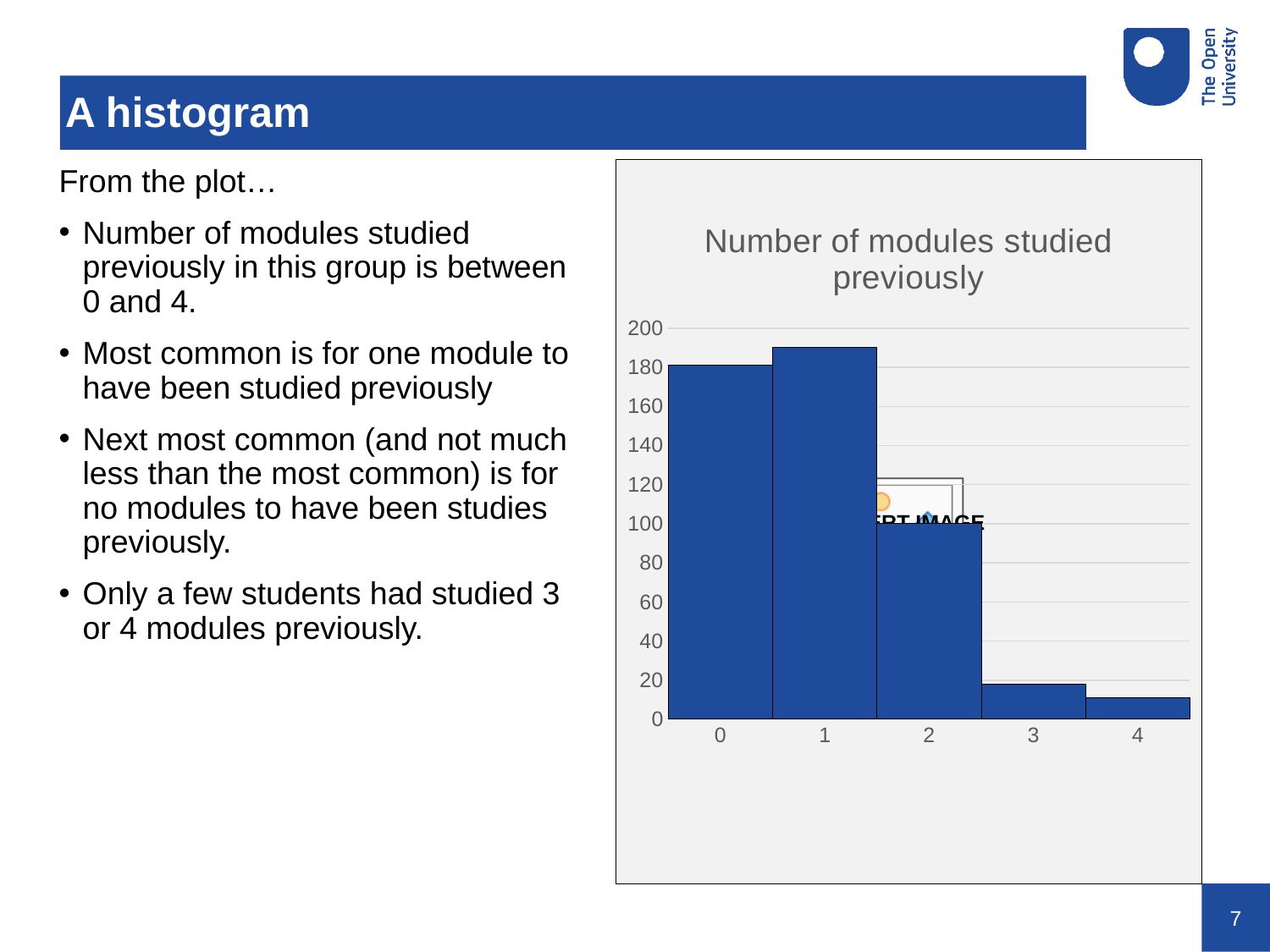
Is the value for 3 modules greater or less than 40? less Is the value for 1 module greater or less than 180? greater Which number of modules has the highest bar? 1 Is the value for 0 modules greater or less than 160? greater What kind of chart is shown on the slide? Bar chart (histogram) What is the title of the chart? Number of modules studied previously Which has the larger value, 0 modules or 2 modules? 0 modules How many categories are shown on the x axis of the chart? 5 Which number of modules has the lowest bar? 4 Do the values rise or fall along the x axis from 1 module to 4 modules? fall